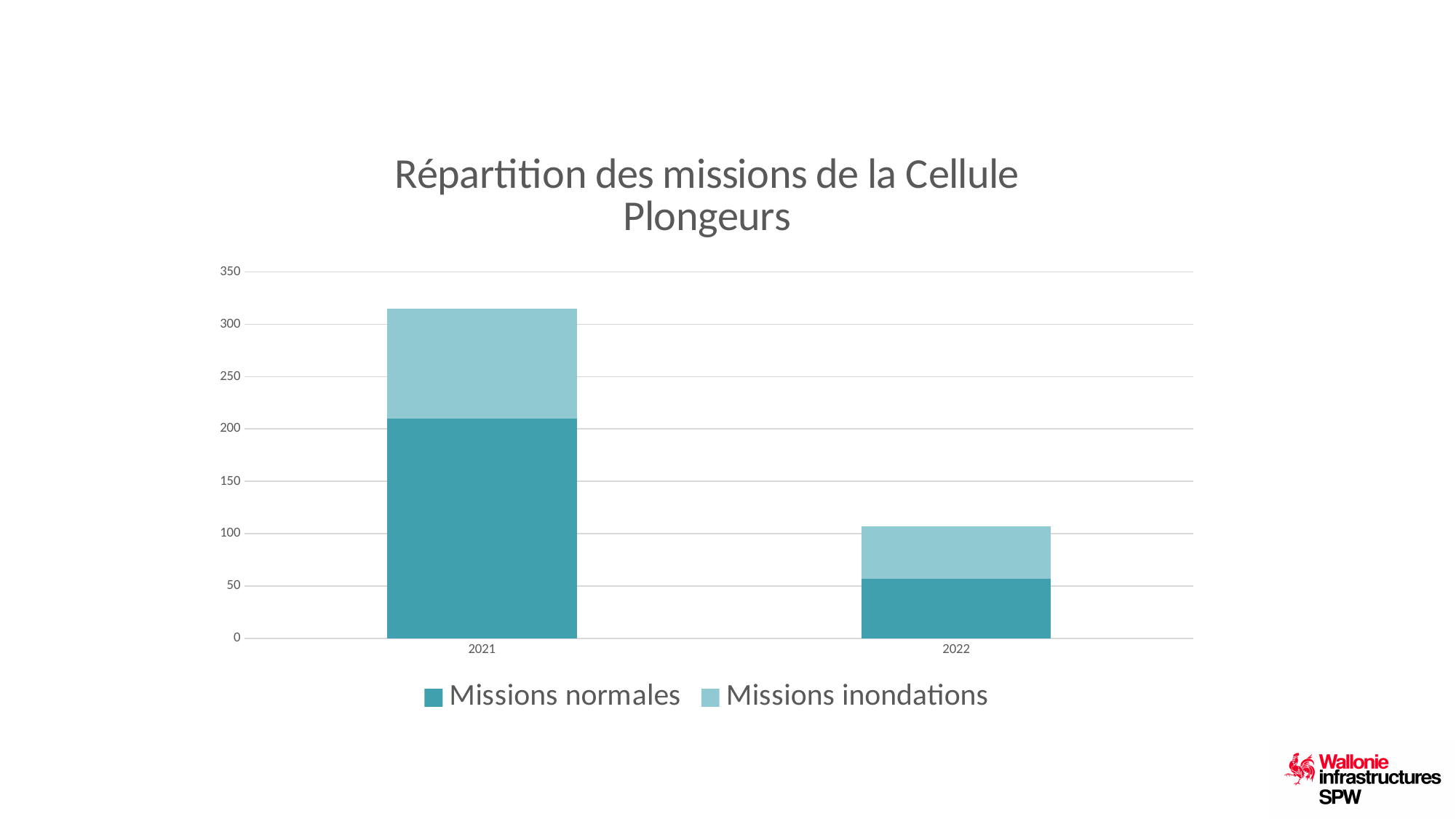
Is the total height of the 2022 bar greater or less than 150? less What kind of chart is shown on the slide? Stacked bar chart Which year has the taller stacked bar, 2021 or 2022? 2021 Is the total height of the 2021 bar greater or less than 300? greater What is the title of the chart? Répartition des missions de la Cellule Plongeurs How many years (categories) are shown on the x axis? 2 How many series does the legend list? 2 In 2021, which segment is larger: Missions normales or Missions inondations? Missions normales Is the value for Missions normales in 2021 greater or less than 150? greater Do the total missions rise or fall from 2021 to 2022? Fall Which series are listed in the legend? Missions normales, Missions inondations